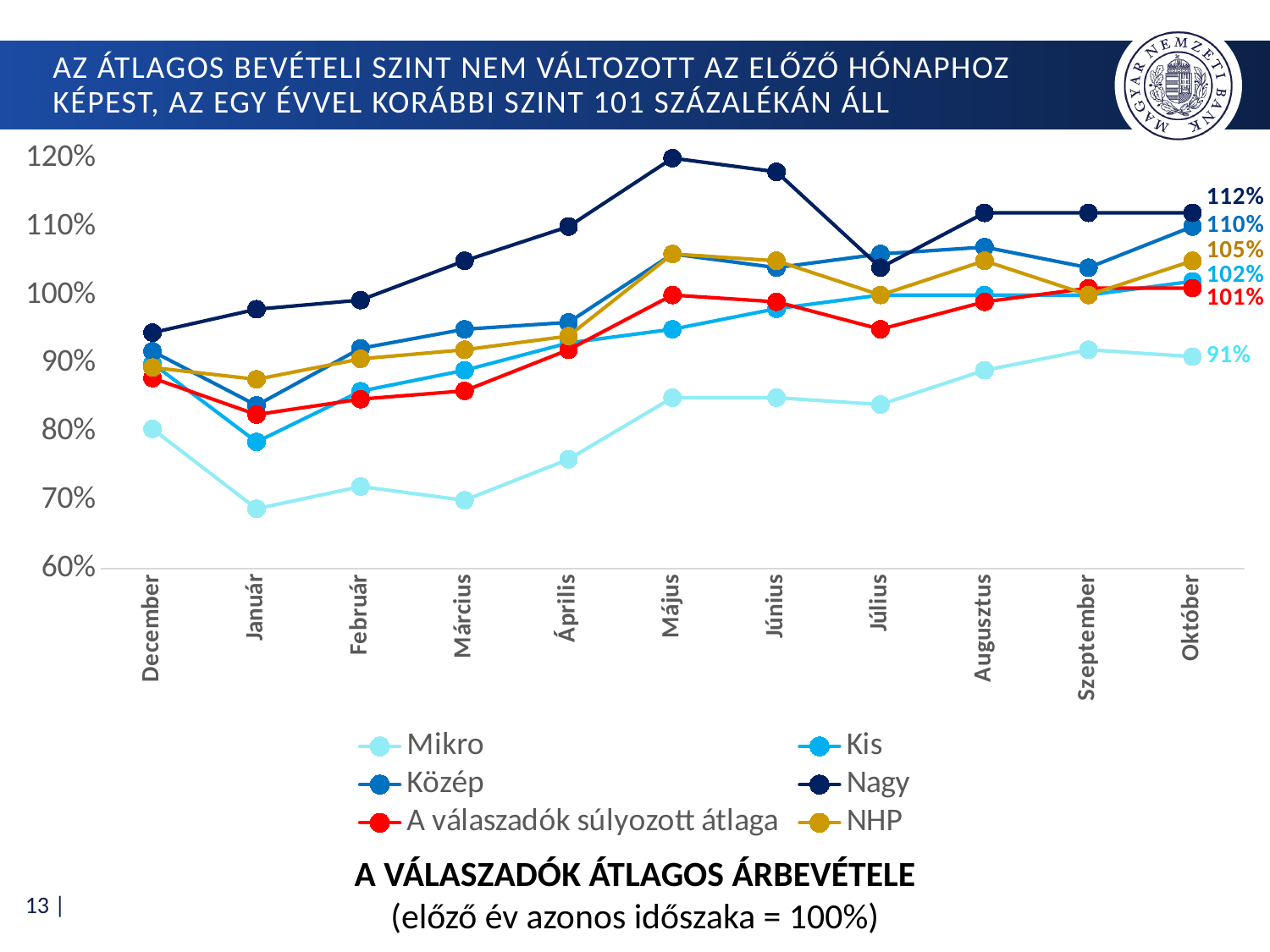
What is the value for Mikro in Október? 91% Does the Mikro series rise or fall from Július to Szeptember? rise What kind of chart is shown on the slide? line chart What is the difference between the Október values of Nagy and Mikro? 21 percentage points How many months are shown on the x axis? 11 What is the value for Kis in Október? 102% Is the value for Mikro in Január greater or less than 70%? less Which series has the lowest value in Október? Mikro What is the value for NHP in Október? 105% Which series has the highest value in Május? Nagy What is the value for Nagy in Október? 112% How many series does the legend list? 6